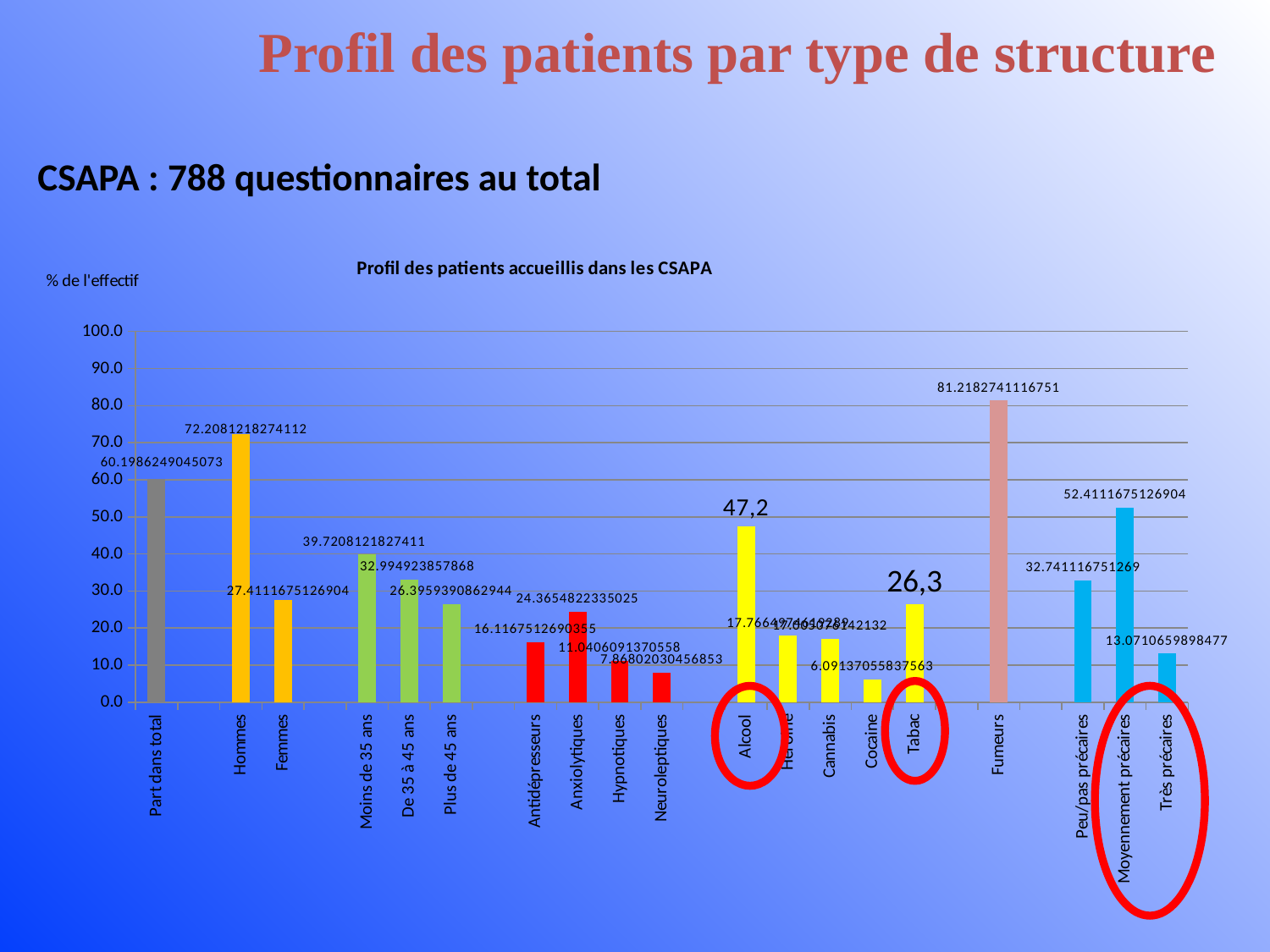
What is the value for Tabac in the chart? 26,3 What is the value for Moyennement précaires in the chart? 52.4111675126904 What is the value for Fumeurs in the chart? 81.2182741116751 Is the value for Héroïne greater or less than 20? less What is the title of the chart? Profil des patients accueillis dans les CSAPA Which category has the highest value in the chart? Fumeurs Which category has the lowest value in the chart? Cocaine Which is larger, the value for Hommes or the value for Femmes? Hommes What kind of chart is shown on the slide? bar chart What is the value for Alcool in the chart? 47,2 What is the difference between the values for Alcool and Tabac? 20,9 How many categories are shown on the x axis of the chart? 19